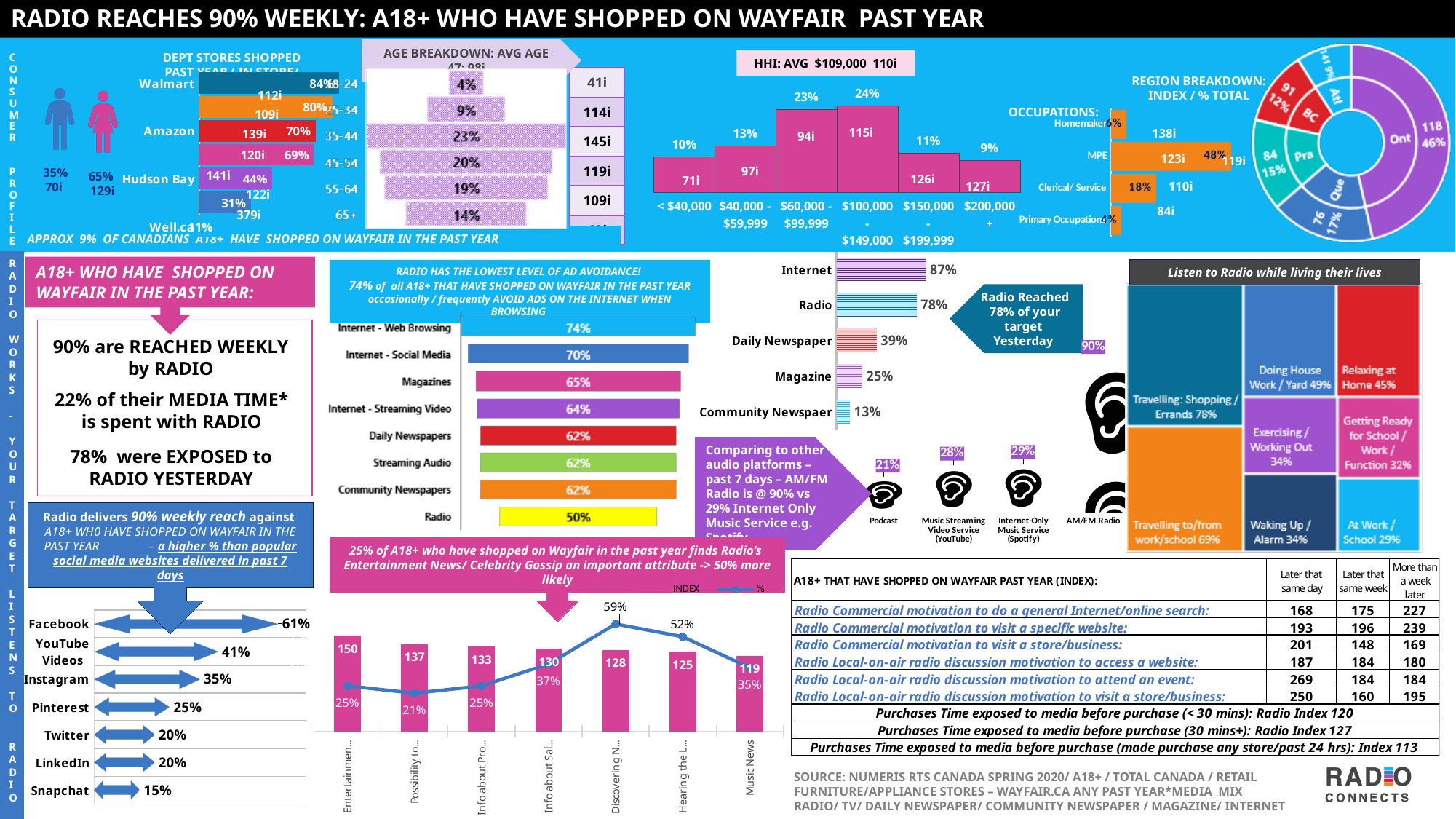
In the ad avoidance bar chart (center of the slide), what is the difference between Internet - Web Browsing and Radio? 24% In the social media weekly reach chart (bottom left), how many social media platforms are listed? 7 In the HHI chart (top center), what percentage is shown for the $100,000 - $149,000 income group? 24% In the ad avoidance bar chart (center of the slide), what percentage is shown for Radio? 50% In the ad avoidance bar chart (center of the slide), which medium has the highest value? Internet - Web Browsing In the audio platforms past 7 days chart (Podcast, Music Streaming Video Service, Internet-Only Music Service, AM/FM Radio), what percentage is shown for Podcast? 21% In the social media weekly reach chart (bottom left), what percentage is shown for Instagram? 35% In the 'reached yesterday' chart (Internet, Radio, Daily Newspaper, Magazine, Community Newspaper), what percentage is shown for Daily Newspaper? 39% In the index/% combo chart at the bottom center, do the index bar values rise or fall from left to right? fall In the 'reached yesterday' chart (Internet, Radio, Daily Newspaper, Magazine, Community Newspaper), which medium has the lowest value? Community Newspaper In the HHI chart (top center), which income group has the highest index? $200,000 + In the index/% combo chart at the bottom center, what index value is shown for Music News? 119